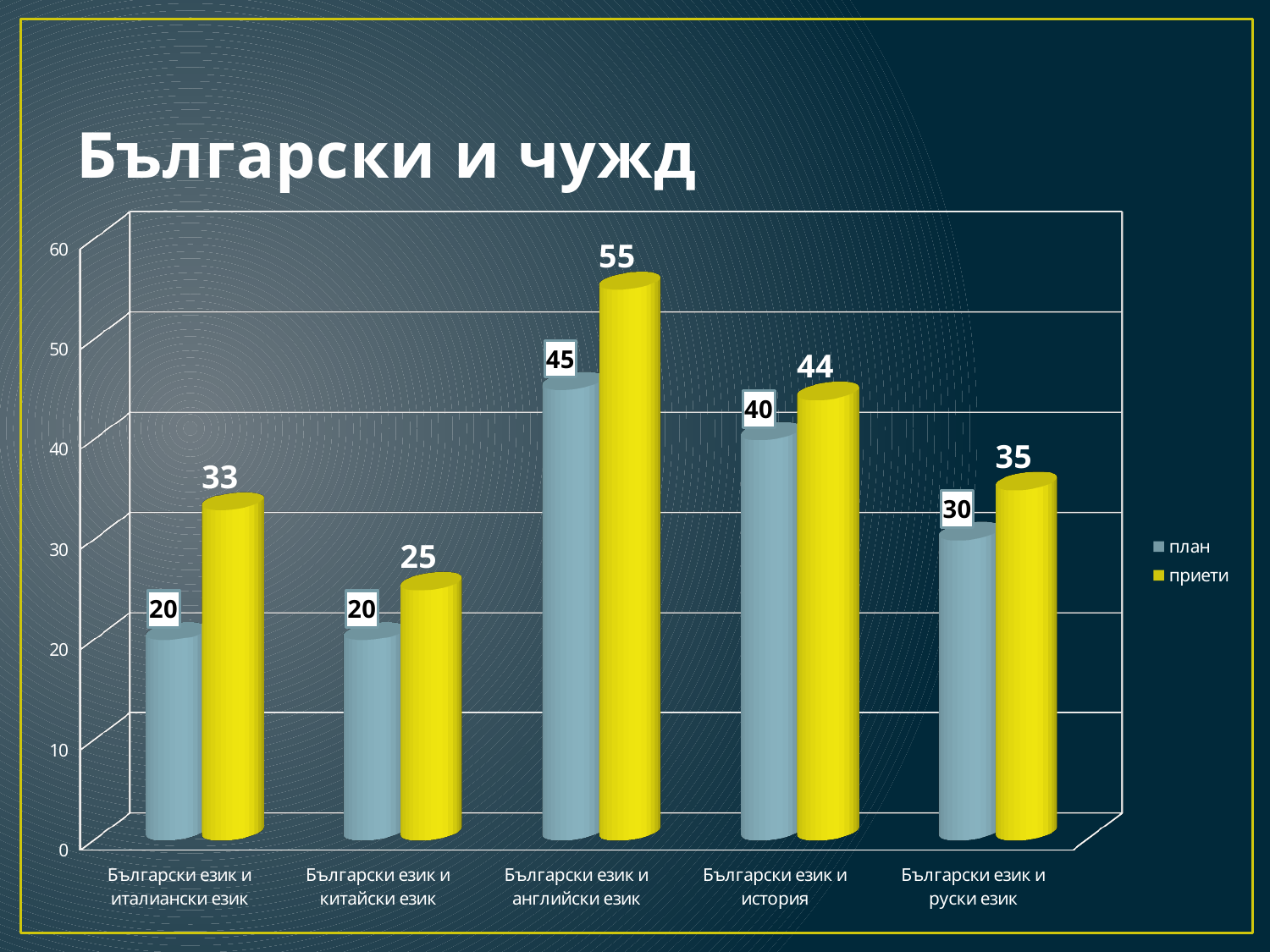
What is the difference between "приети" and "план" for "Български език и история"? 4 Which category has the highest "приети" value? Български език и английски език What is the value of "план" for "Български език и история"? 40 Which category has the lowest "приети" value? Български език и китайски език How many series does the legend list? 2 What kind of chart is shown on the slide? bar chart What is the value of "приети" for "Български език и руски език"? 35 How many categories are shown on the x axis? 5 What is the difference between "приети" and "план" for "Български език и италиански език"? 13 Which is larger for "Български език и китайски език": "план" or "приети"? приети What is the value of "приети" for "Български език и английски език"? 55 What is the title of the slide? Български и чужд